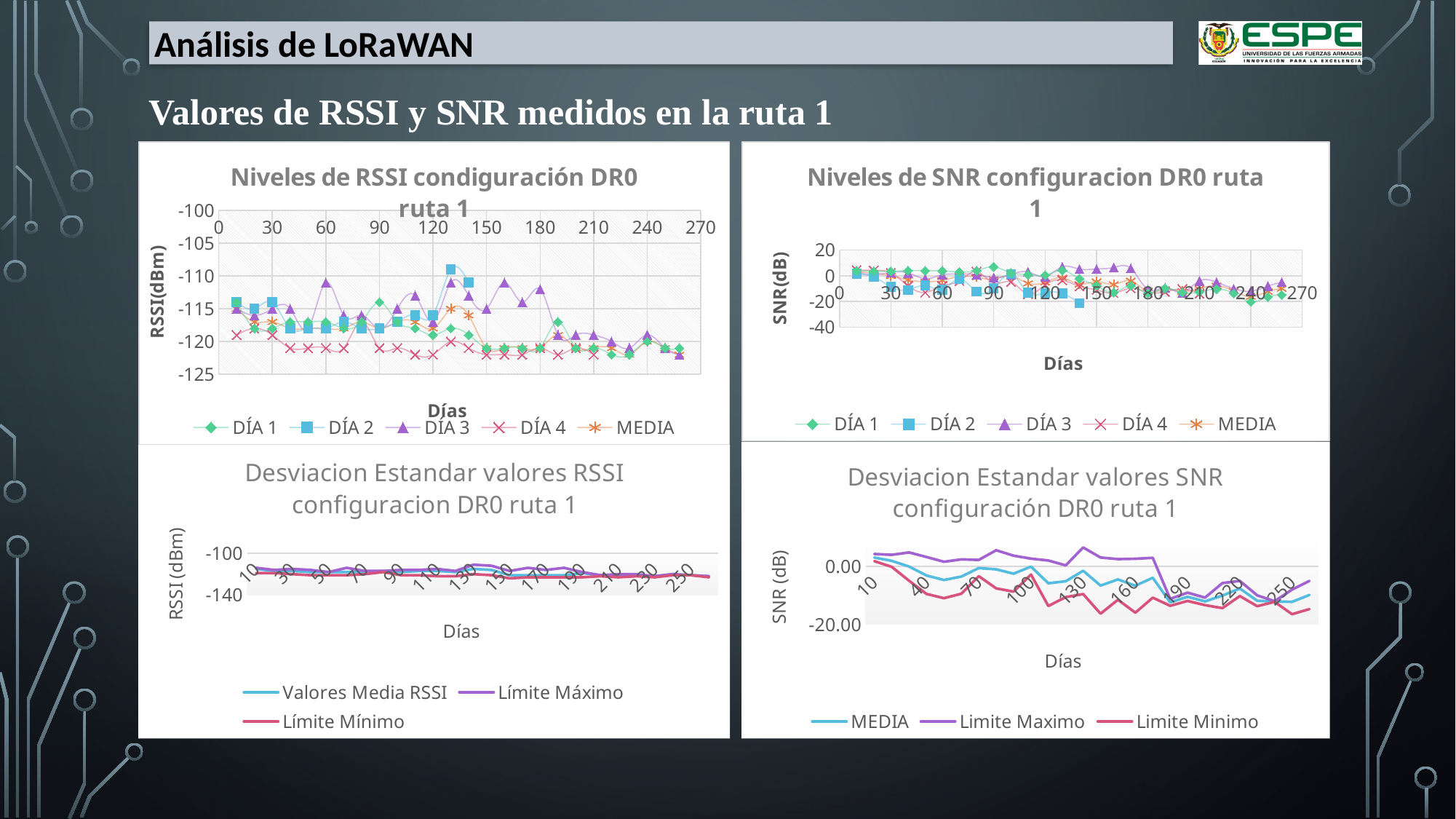
In the chart titled 'Niveles de RSSI condiguración DR0 ruta 1', is the DÍA 4 value at day 10 greater or less than -115? less In the chart titled 'Niveles de SNR configuracion DR0 ruta 1', do the DÍA 3 values overall rise or fall from day 0 to day 270? fall In the chart titled 'Niveles de RSSI condiguración DR0 ruta 1', is the highest DÍA 2 value greater or less than -115? greater In the chart titled 'Niveles de RSSI condiguración DR0 ruta 1', how many series does the legend list? 5 In the chart titled 'Niveles de SNR configuracion DR0 ruta 1', is the DÍA 3 value at day 30 greater or less than -20? greater In the chart titled 'Desviacion Estandar valores RSSI configuracion DR0 ruta 1', how many series does the legend list? 3 In the chart titled 'Desviacion Estandar valores SNR configuración DR0 ruta 1', does the Limite Maximo line overall rise or fall from day 10 to day 250? fall In the chart titled 'Niveles de SNR configuracion DR0 ruta 1', what are the series names in the legend? DÍA 1, DÍA 2, DÍA 3, DÍA 4, MEDIA In the chart titled 'Desviacion Estandar valores SNR configuración DR0 ruta 1', what kind of chart is it? line chart In the chart titled 'Niveles de RSSI condiguración DR0 ruta 1', what is the y-axis label? RSSI(dBm)